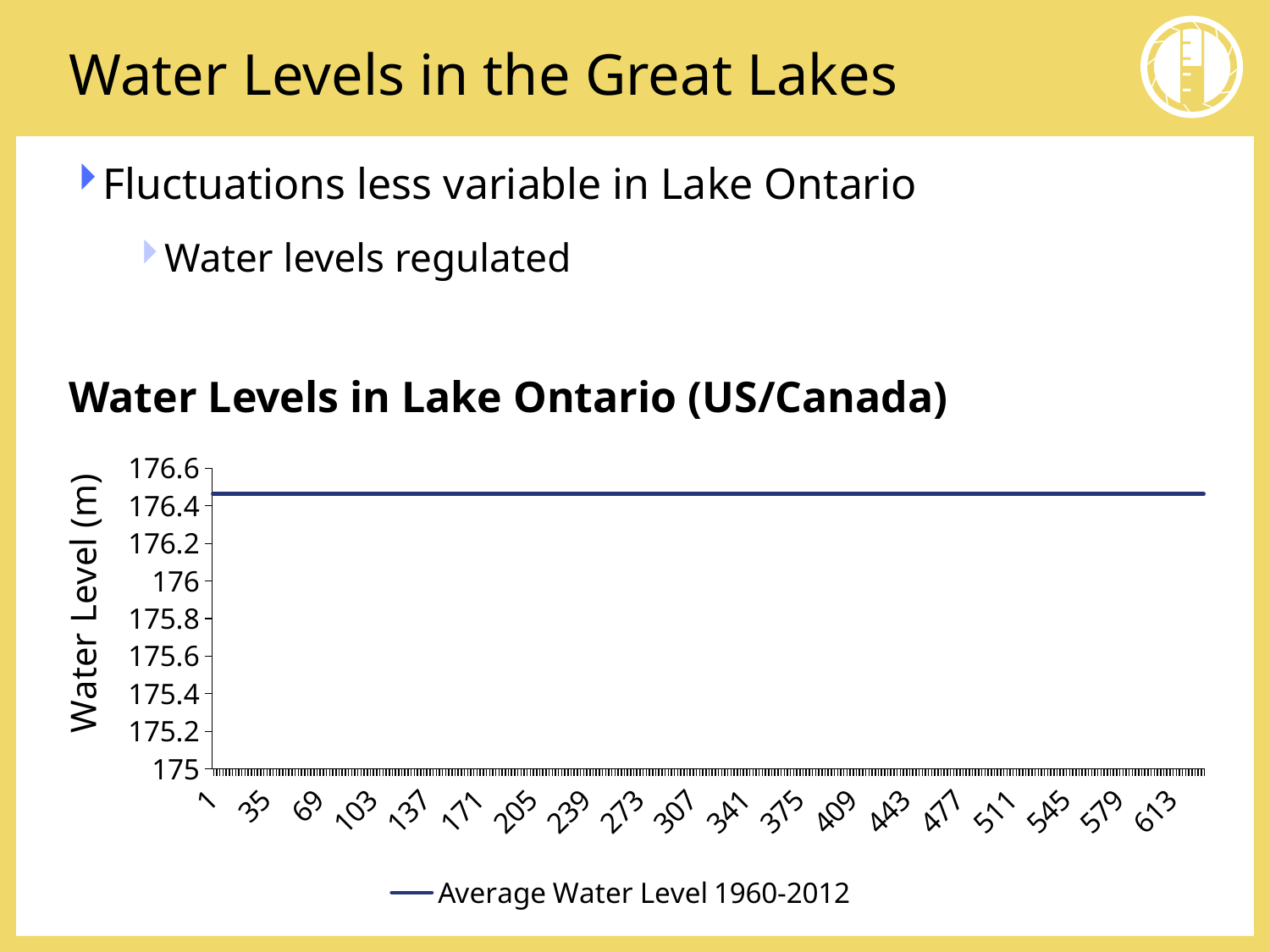
How many series does the legend of the chart list? 1 What kind of chart is shown on the slide? line chart Is the value of the Average Water Level 1960-2012 line greater or less than 176.4? greater Does the plotted line rise, fall, or stay flat along the x axis? stay flat What is the name of the series shown in the chart legend? Average Water Level 1960-2012 Is the value of the Average Water Level 1960-2012 line greater or less than 175.8? greater Is the value of the Average Water Level 1960-2012 line greater or less than 176.6? less What is the title of the chart? Water Levels in Lake Ontario (US/Canada)